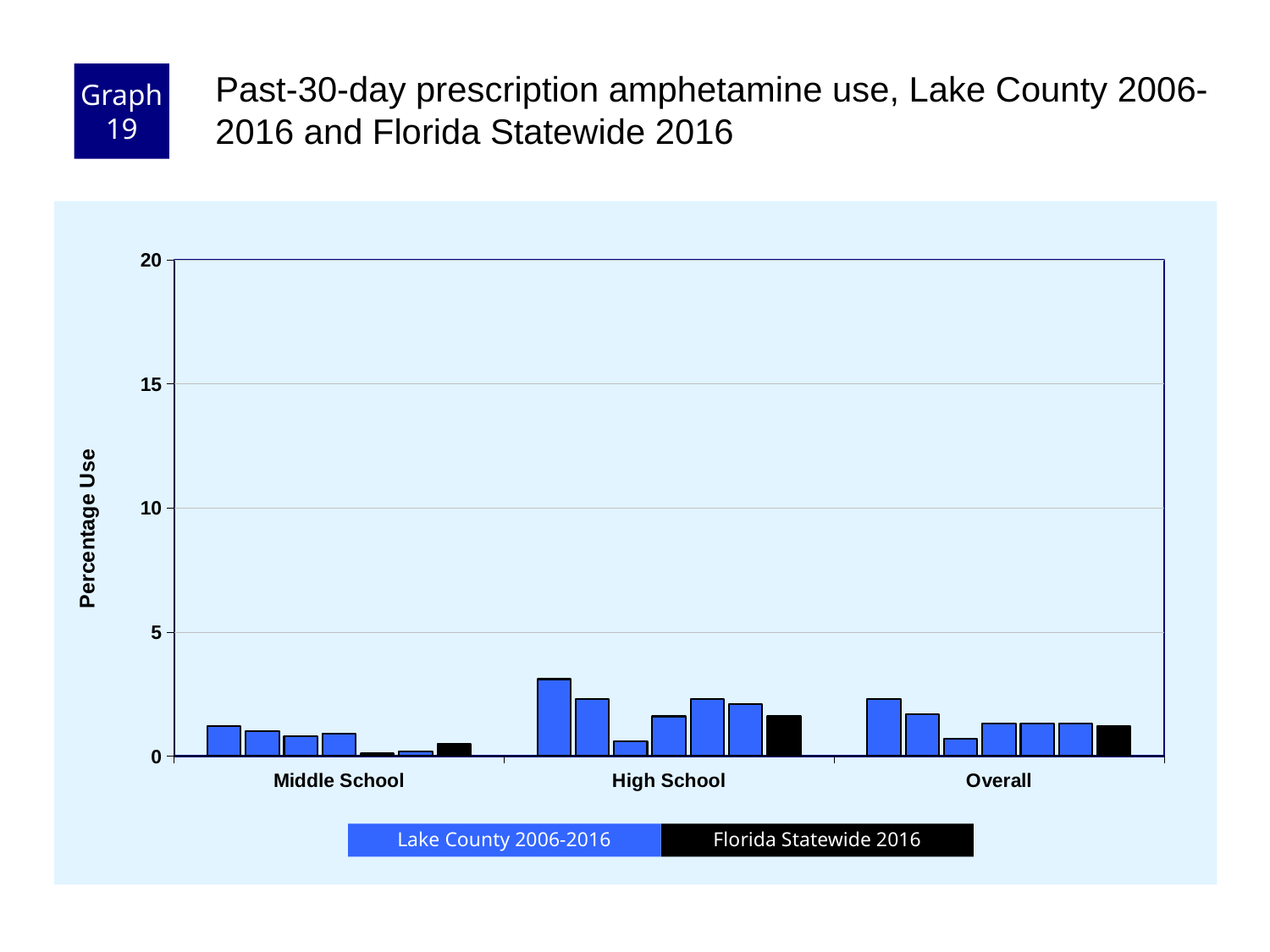
What is the label on the y axis? Percentage Use Which colour represents Florida Statewide 2016 in the legend? black Is the tallest Lake County 2006-2016 bar for High School greater or less than 5? less Do the Lake County 2006-2016 bars for Middle School generally rise or fall from left to right? fall Is the Florida Statewide 2016 value for Middle School greater or less than 5? less Is the Florida Statewide 2016 value for High School greater or less than 5? less How many series does the legend list? 2 How many categories are shown on the x axis? 3 Which category group has the lowest bars overall? Middle School Which category group contains the tallest bar? High School What kind of chart is shown on the slide? bar chart Which is larger, the Florida Statewide 2016 bar for High School or the Florida Statewide 2016 bar for Middle School? High School